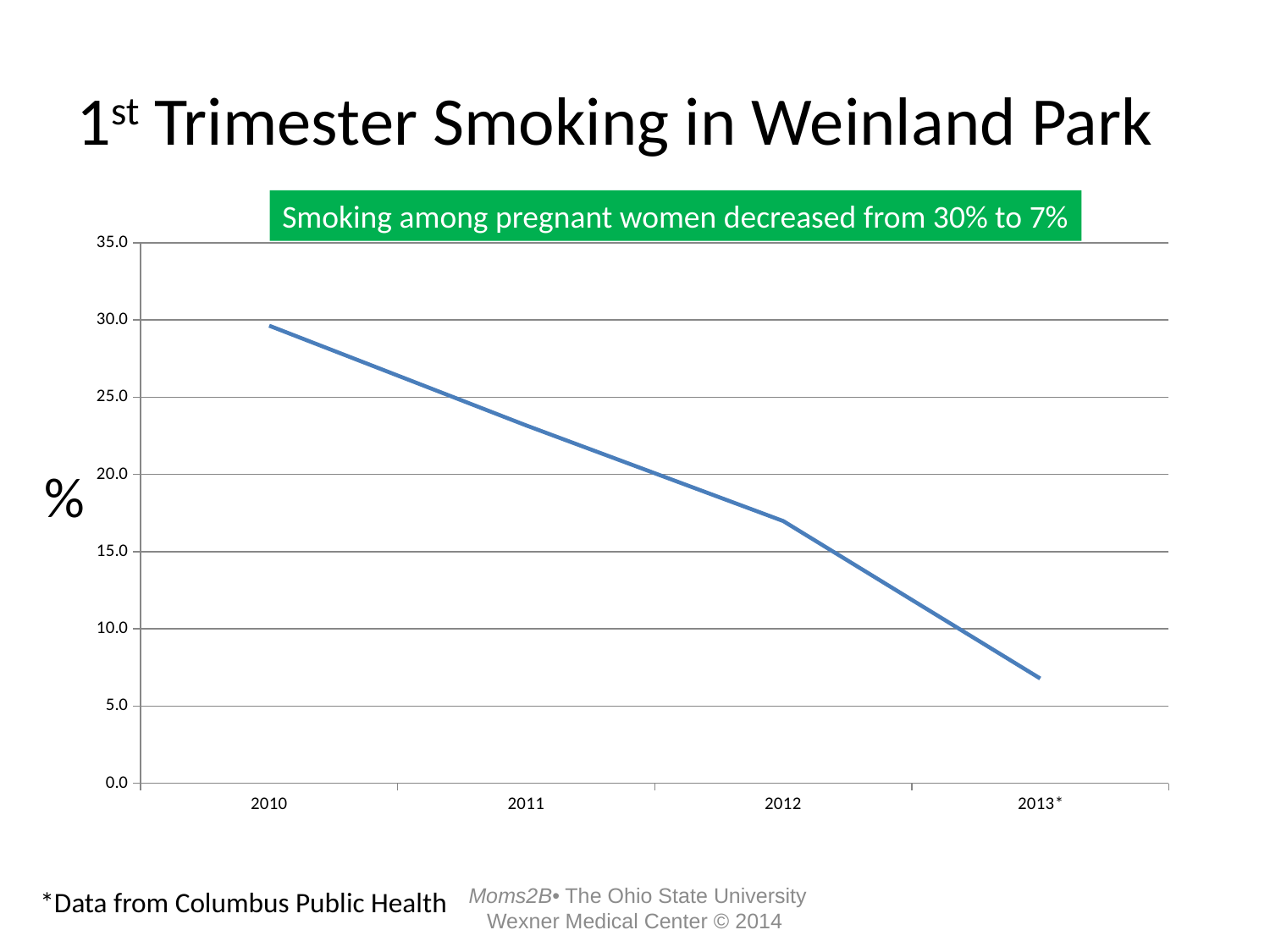
Which year has the lowest 1st trimester smoking percentage? 2013* Is the value for 2011 greater or less than 20.0? greater Which year has a larger value, 2011 or 2012? 2011 Do the values rise or fall from 2010 to 2013*? fall Is the value for 2012 greater or less than 20.0? less How many years are plotted on the x axis? 4 Is the value for 2013* greater or less than 10.0? less What is the title of the slide? 1st Trimester Smoking in Weinland Park Which year has the highest 1st trimester smoking percentage? 2010 What kind of chart is shown on the slide? line chart